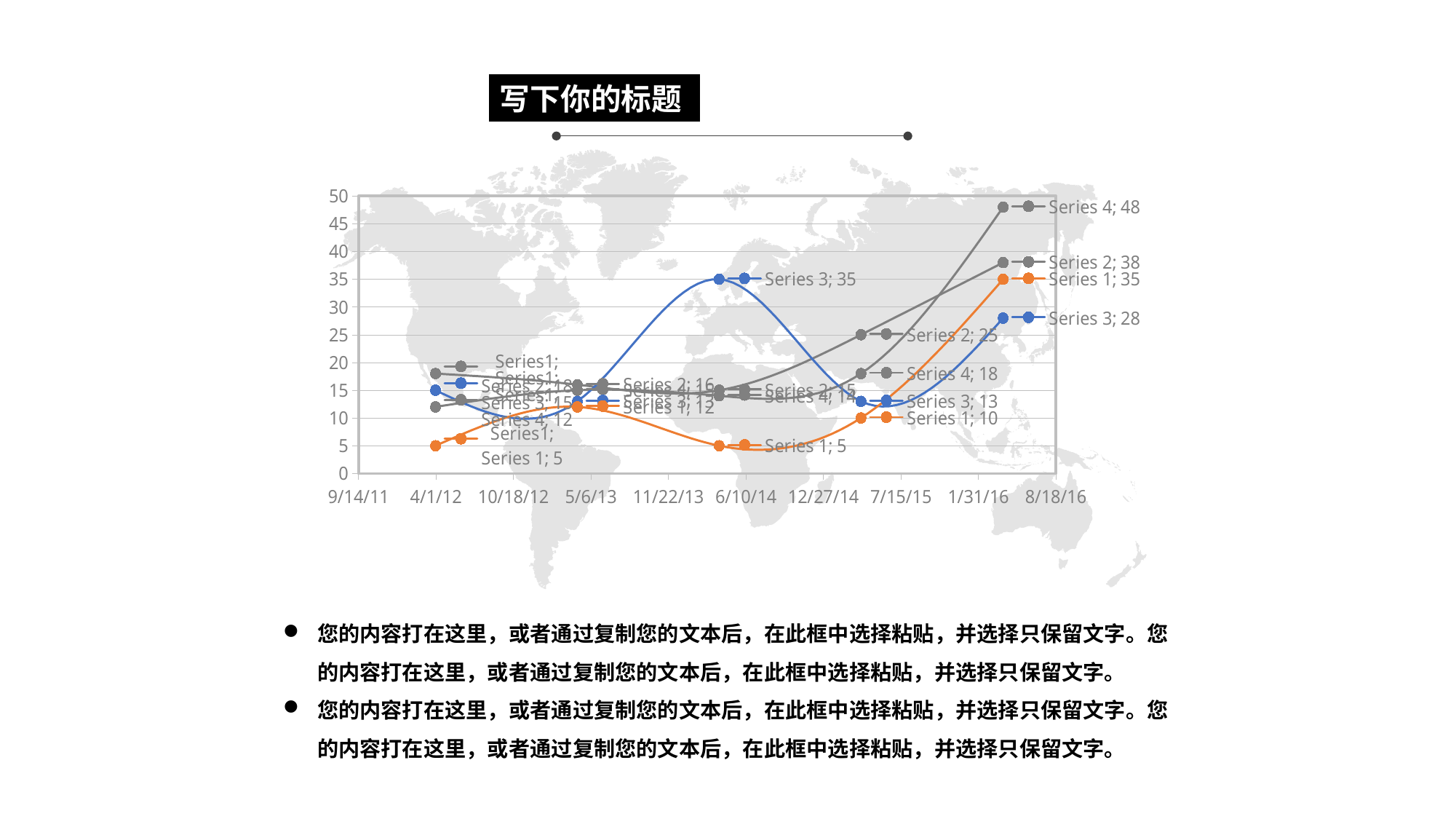
What is the difference between Series 2 (25) and Series 4 (18) at the point near 7/15/15? 7 What is the peak value reached by Series 3 around 6/10/14? 35 What is the value of the last data point of Series 4? 48 What type of chart is shown on the slide? line chart At the last data point, which is larger: Series 1 or Series 3? Series 1 What is the difference between the last data points of Series 4 (48) and Series 2 (38)? 10 Does Series 4 rise or fall between the point near 7/15/15 and its last point? rise What is the value of the last data point of Series 2? 38 What is the value of the last data point of Series 3? 28 What is the value of the last data point of Series 1? 35 How many series are plotted on the chart? 4 What is the highest labeled value on the chart, and which series does it belong to? 48, Series 4